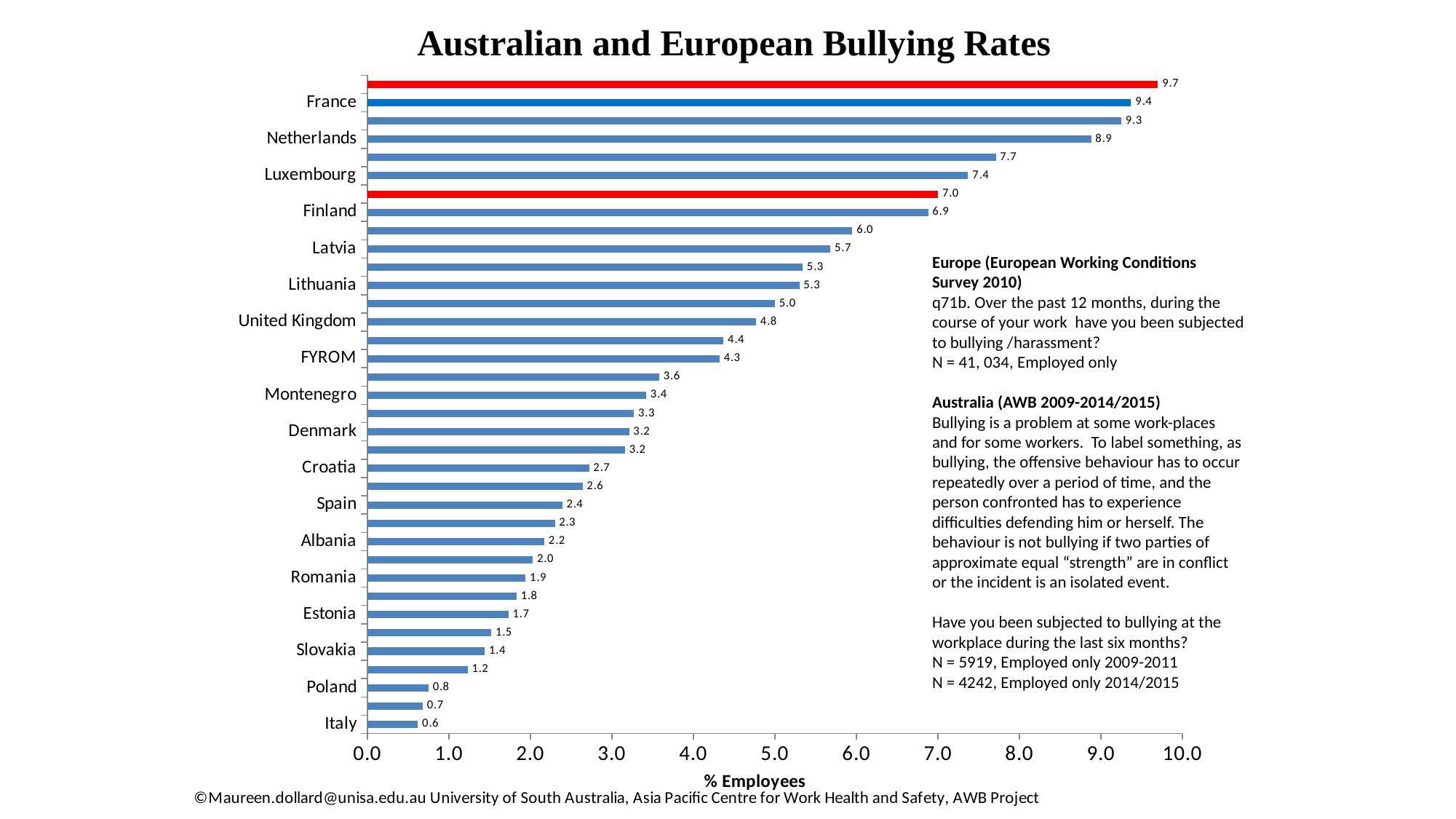
What is the bullying rate for the United Kingdom? 4.8 Which has a higher bullying rate, Latvia or Lithuania? Latvia What is the highest value shown on the chart? 9.7 What is the title of the x axis? % Employees Is the value for Finland greater or less than 7.0? less What is the bullying rate for France? 9.4 Which labelled country has the lowest bullying rate? Italy How many bars are plotted on the chart? 36 What is the bullying rate for Italy? 0.6 What is the difference between the bullying rates of France and the Netherlands? 0.5 What is the bullying rate for the Netherlands? 8.9 What type of chart is shown on the slide? bar chart